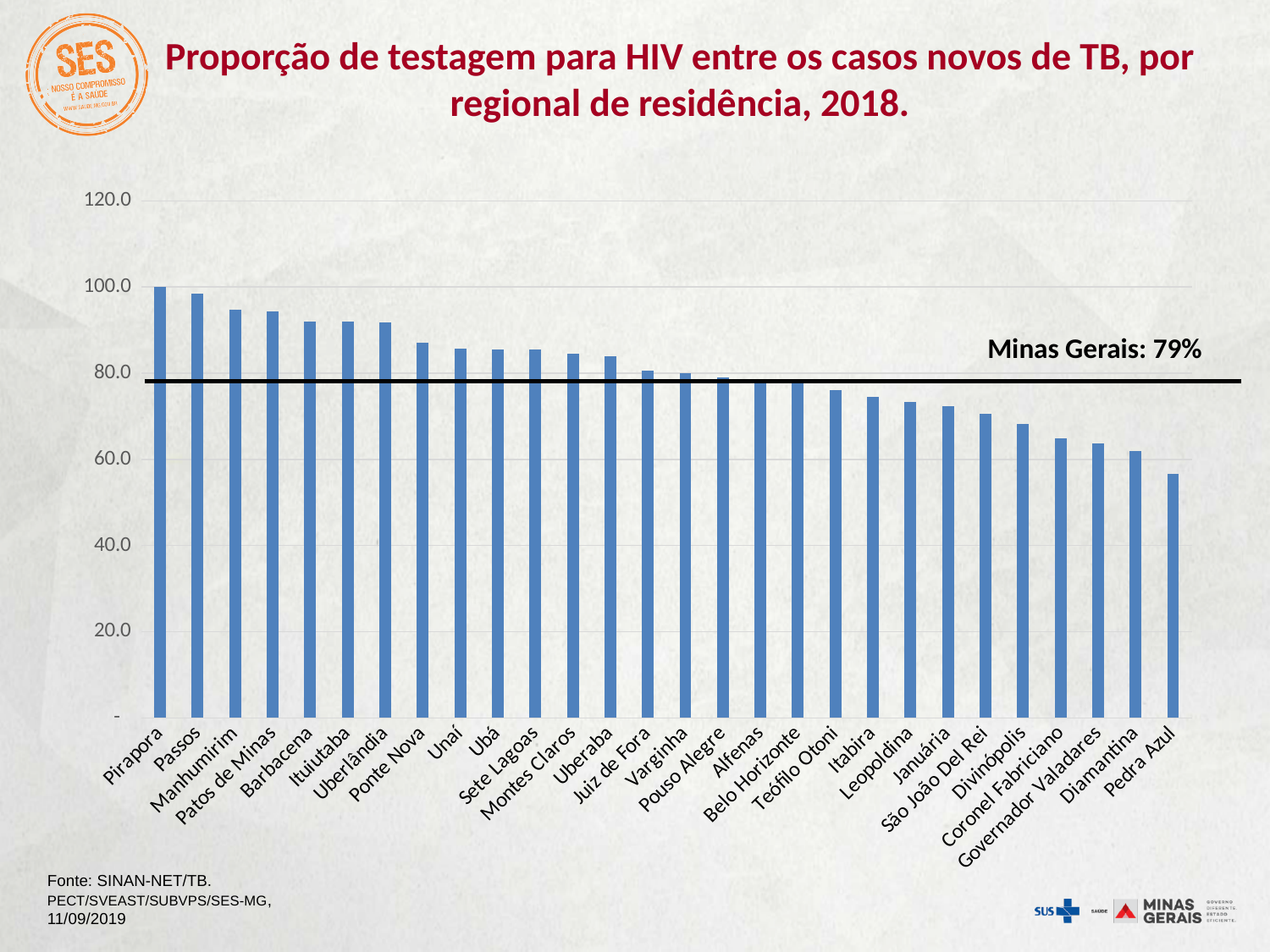
Which regional has the highest proportion of HIV testing among new TB cases? Pirapora Is the value for Passos greater or less than 80? greater Is the value for Divinópolis greater or less than 80? less What value is given for Minas Gerais on the reference line label? 79% Do the values rise or fall moving from left to right along the x axis? fall Which regional has the lowest proportion of HIV testing among new TB cases? Pedra Azul What kind of chart is shown on the slide? bar chart How many regionals are plotted on the chart? 28 What is the source cited at the bottom of the slide? SINAN-NET/TB Is the value for Pedra Azul greater or less than 60? less Which has a higher value, Passos or Januária? Passos